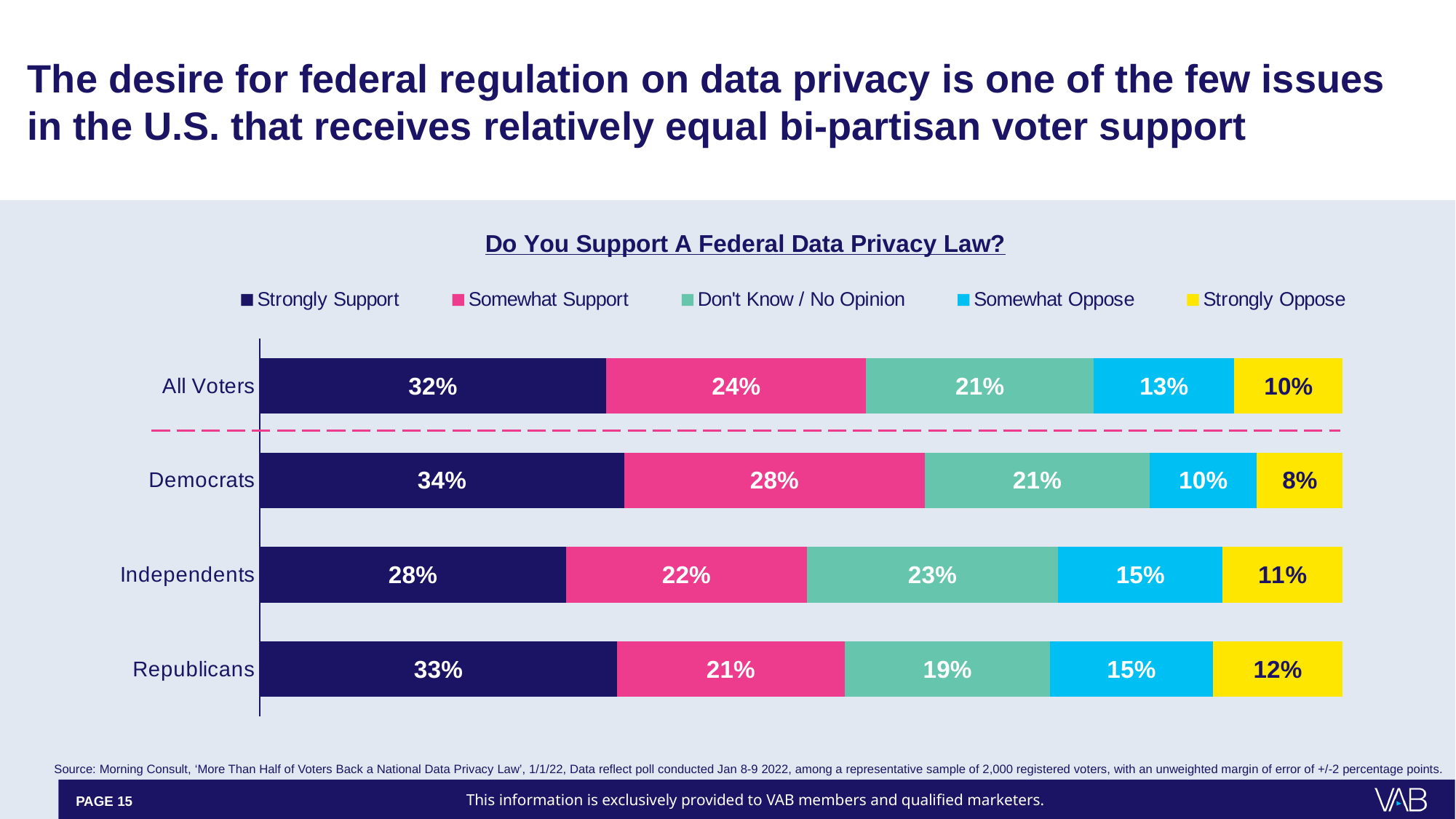
What kind of chart is shown on the slide? Stacked bar chart What percentage of Democrats Strongly Support a federal data privacy law? 34% What is the Somewhat Oppose value for All Voters? 13% Which voter group has the highest Strongly Support percentage? Democrats Which voter group has the lowest Strongly Oppose percentage? Democrats What percentage of Republicans Strongly Oppose a federal data privacy law? 12% What is the Don't Know / No Opinion value for Independents? 23% What is the title of the chart? Do You Support A Federal Data Privacy Law? Which group has a larger Somewhat Oppose value, Independents or Democrats? Independents What is the difference in Somewhat Support between Democrats and Republicans? 7 percentage points How many response categories does the legend list? 5 How many voter groups are shown in the chart? 4